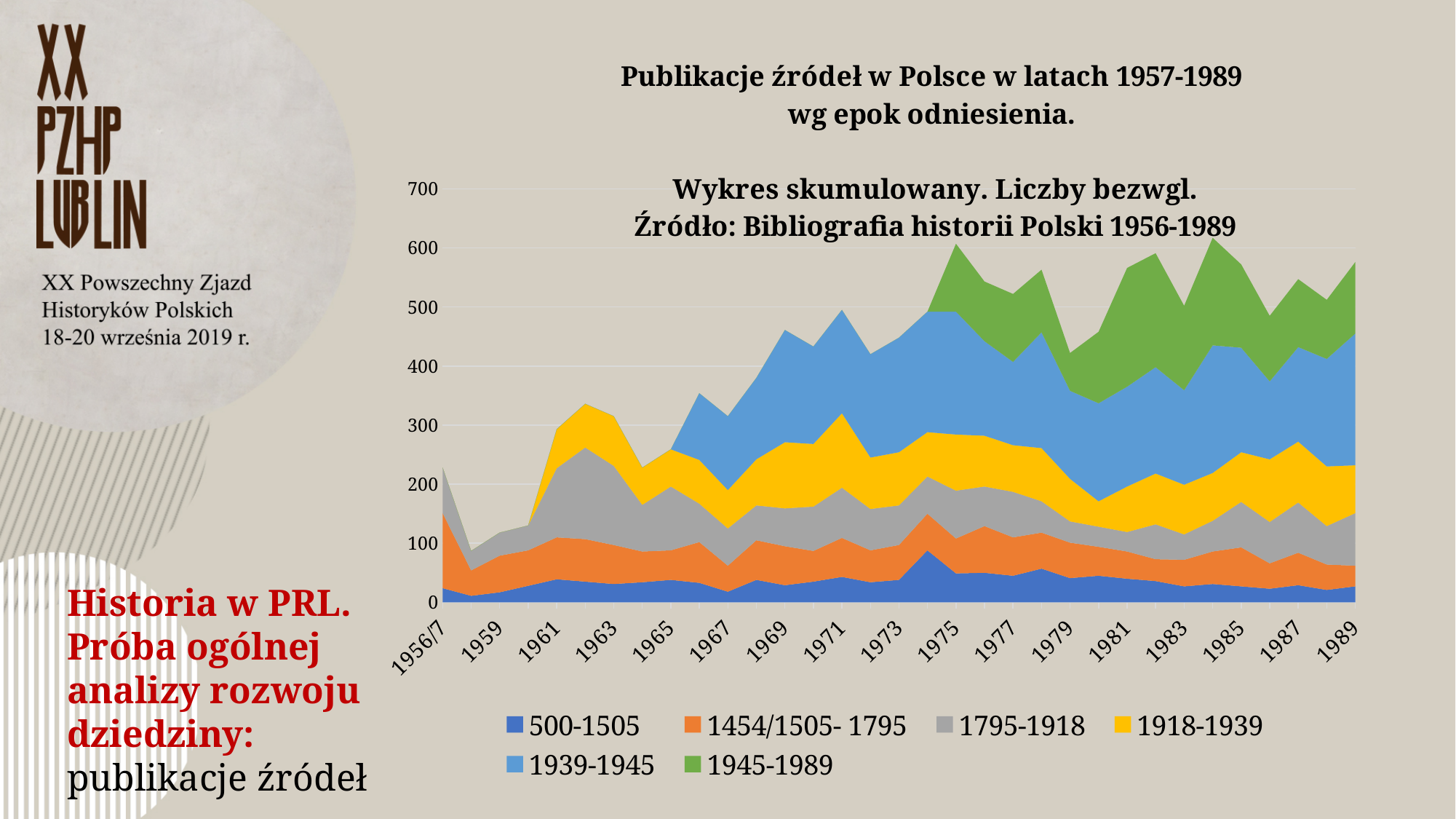
Which colour represents the series 1945-1989 in the legend? green Is the total stacked value for 1979 greater or less than 300? greater How many series does the legend list? 6 Does the total stacked value rise or fall overall from 1956/7 to 1989? rise Is the total stacked value for 1975 greater or less than 500? greater Is the total stacked value for 1959 greater or less than 200? less What is the highest value shown on the vertical axis? 700 What kind of chart is shown on the slide? stacked area chart What is the title of the chart? Publikacje źródeł w Polsce w latach 1957-1989 wg epok odniesienia.